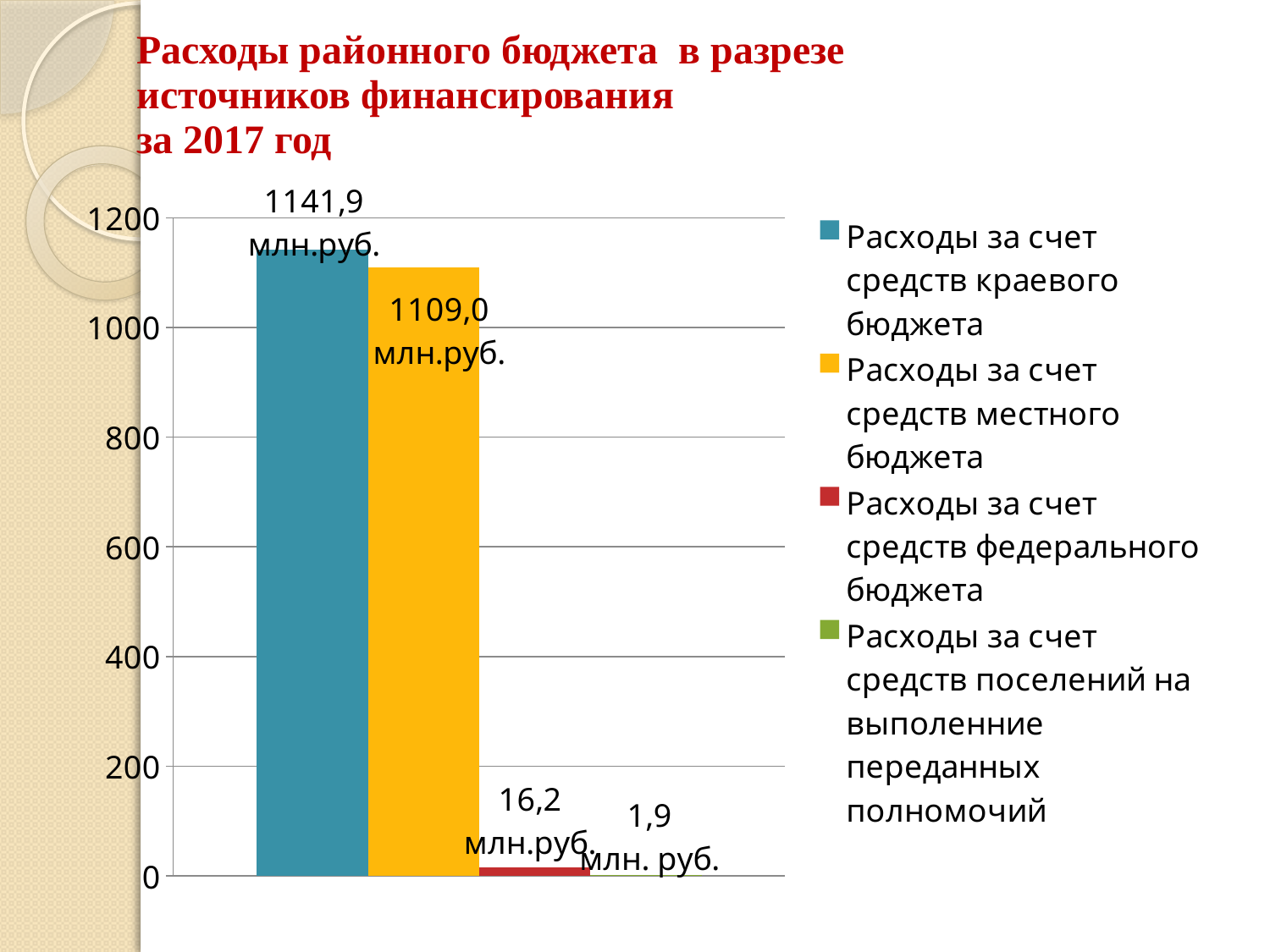
What is the value for expenses funded by the federal budget? 16,2 млн.руб. What is the value for expenses funded by settlement (поселений) funds for transferred powers? 1,9 млн. руб. Which is larger: expenses from the local (местный) budget or from the federal budget? Расходы за счет средств местного бюджета What is the difference between expenses from the federal budget and from settlement funds? 14,3 млн.руб. How many series does the legend list? 4 Which funding source has the highest expenses? Расходы за счет средств краевого бюджета What is the difference between expenses from the regional (краевой) budget and the local (местный) budget? 32,9 млн.руб. What colour is the bar for expenses from the local (местный) budget? Yellow Which funding source has the lowest expenses? Расходы за счет средств поселений на выполенние переданных полномочий What is the value for expenses funded by the local (местный) budget? 1109,0 млн.руб. What is the value for expenses funded by the regional (краевой) budget? 1141,9 млн.руб. What kind of chart is shown on the slide? Bar chart